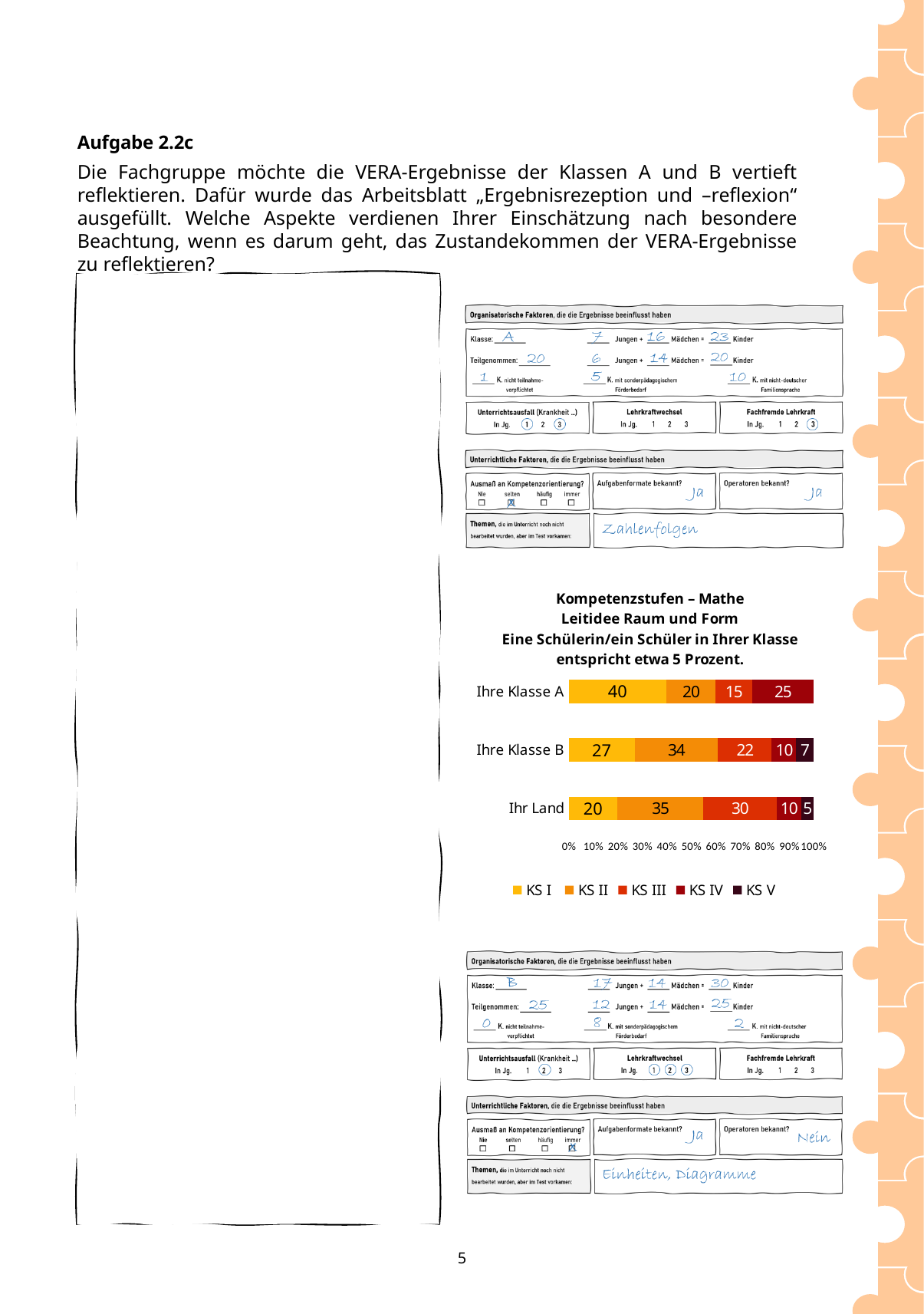
In the Kompetenzstufen chart, is the KS IV value larger for Ihre Klasse A or Ihre Klasse B? Ihre Klasse A In the Kompetenzstufen chart, what is the difference between the KS II values of Ihr Land and Ihre Klasse A? 15 How many series does the legend of the Kompetenzstufen chart list? 5 What type of chart is shown under the title "Kompetenzstufen – Mathe"? stacked bar chart In the Kompetenzstufen chart, what is the total of the stacked bar for Ihr Land? 100 In the Kompetenzstufen chart, what is the KS II value for Ihre Klasse B? 34 How many categories (bars) does the Kompetenzstufen chart show? 3 In the Kompetenzstufen chart, which category has the highest KS I value? Ihre Klasse A In the Kompetenzstufen chart, what is the KS V value for Ihre Klasse B? 7 In the Kompetenzstufen chart, what is the KS III value for Ihr Land? 30 In the Kompetenzstufen chart, what is the KS I value for Ihre Klasse A? 40 In the Kompetenzstufen chart, which category has the lowest KS I value? Ihr Land